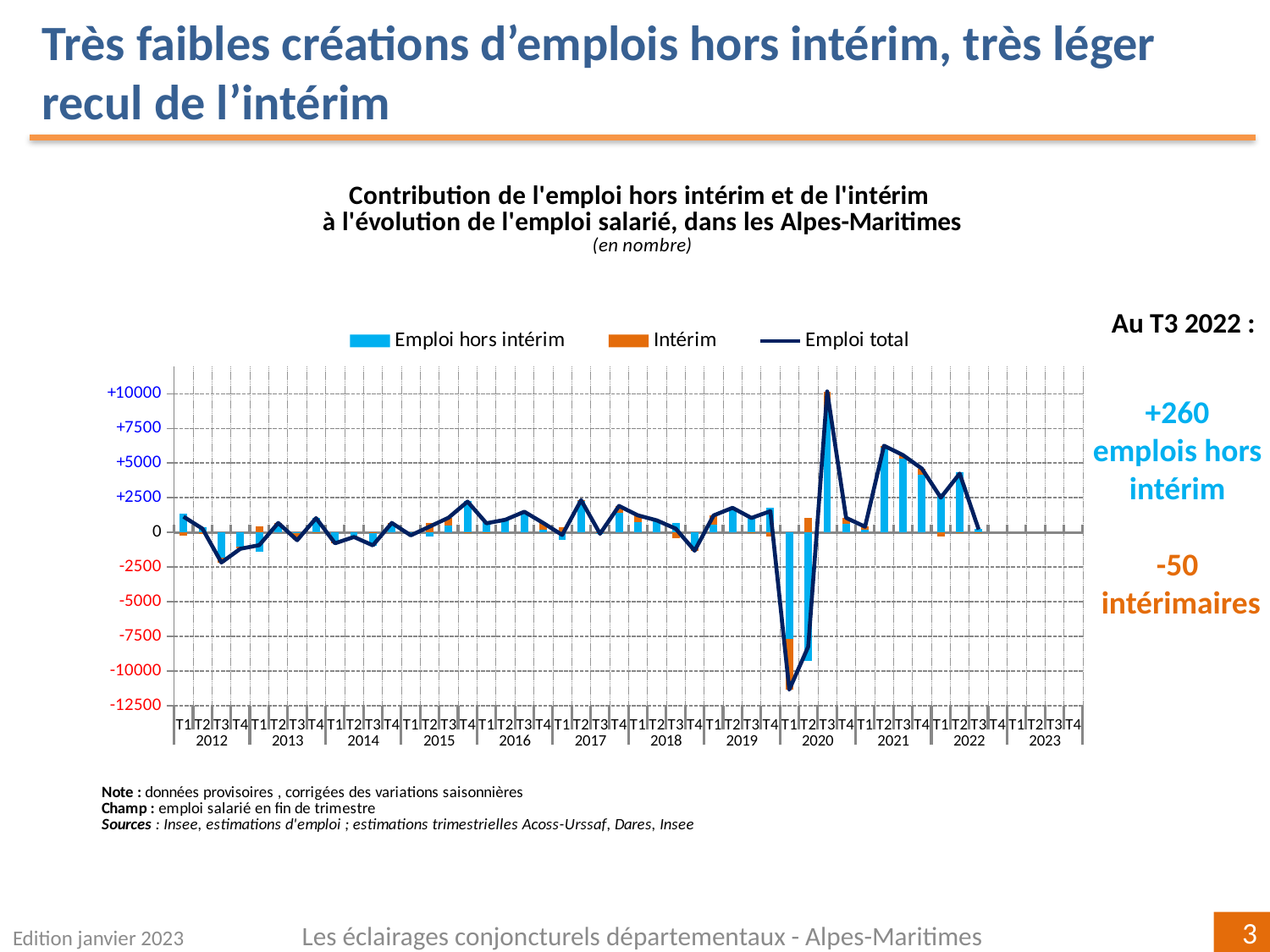
According to the slide, what is the value for Emploi hors intérim in T3 2022? +260 Between T1 2020 and T3 2020, does Emploi total rise or fall? rise Is the value of Emploi hors intérim in T2 2021 greater or less than 5000? greater Which is larger, Emploi total in T3 2020 or Emploi total in T2 2021? T3 2020 How many series does the chart legend list? 3 In which quarter does Emploi total reach its lowest point? T1 2020 In which quarter does Emploi total reach its highest point? T3 2020 According to the slide, what is the value for Intérim in T3 2022? -50 What kind of chart is used to show the contribution of employment in the Alpes-Maritimes? A bar chart combined with a line Is the value of Emploi total in T1 2020 greater or less than -10000? less Is the value of Emploi total in T3 2020 greater or less than 7500? greater What colour are the Intérim bars in the chart? Orange